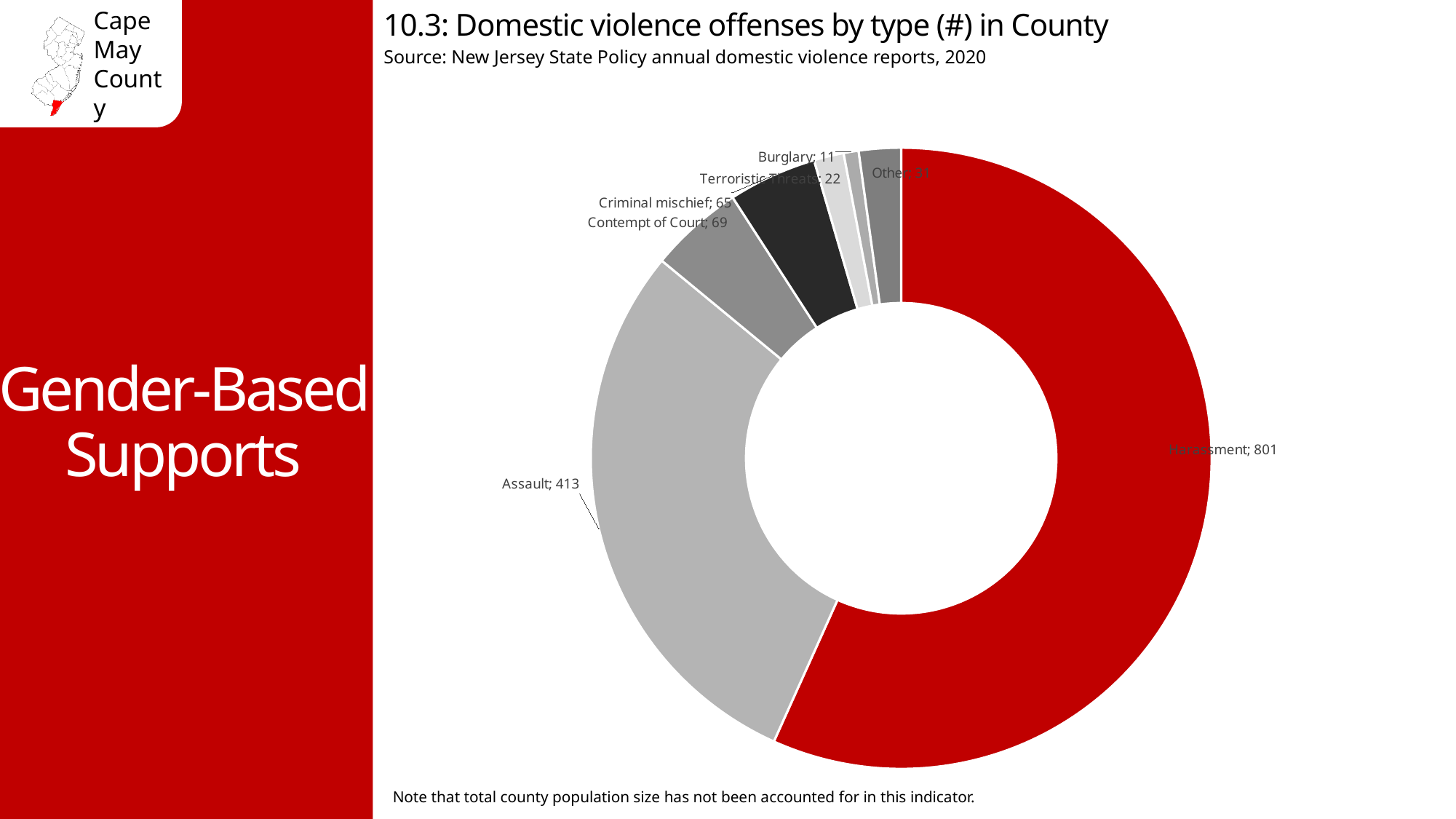
How many offense categories are shown in the chart? 7 What is the value for Assault? 413 What is the value for Contempt of Court? 69 What type of chart is shown on the slide? Doughnut (pie) chart What is the value for Terroristic Threats? 22 What is the value for Burglary? 11 What is the value for Criminal mischief? 65 Which is larger, Contempt of Court or Criminal mischief? Contempt of Court How many domestic violence offenses of type Harassment are shown? 801 What is the difference between the Harassment and Assault values? 388 Which offense type has the largest slice? Harassment Which offense type has the smallest slice? Burglary